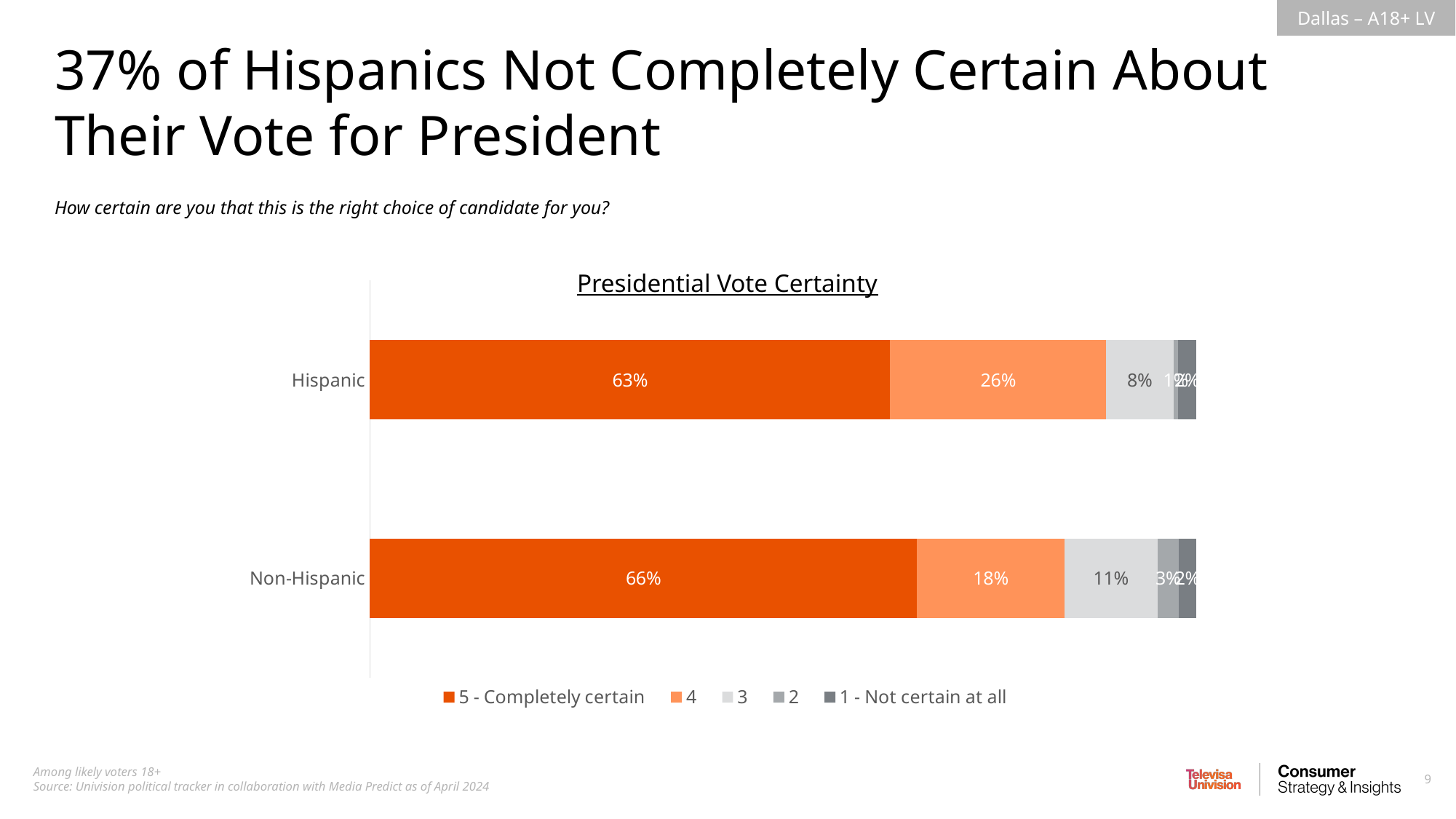
How many groups (categories) are shown in the chart? 2 What is the value for the '3' certainty level among Hispanic voters? 8% What is the value for the '3' certainty level among Non-Hispanic voters? 11% Which group has a larger share of '5 - Completely certain' voters, Hispanic or Non-Hispanic? Non-Hispanic How many series does the legend list? 5 What is the value for the '4' certainty level among Non-Hispanic voters? 18% What kind of chart is shown on the slide? Stacked bar chart What is the value for the '4' certainty level among Hispanic voters? 26% What is the difference between the Non-Hispanic and Hispanic shares of '5 - Completely certain' voters? 3 percentage points What percentage of Non-Hispanic likely voters are '5 - Completely certain' about their vote for President? 66% What is the difference between the Hispanic and Non-Hispanic shares at certainty level '4'? 8 percentage points What percentage of Hispanic likely voters are '5 - Completely certain' about their vote for President? 63%